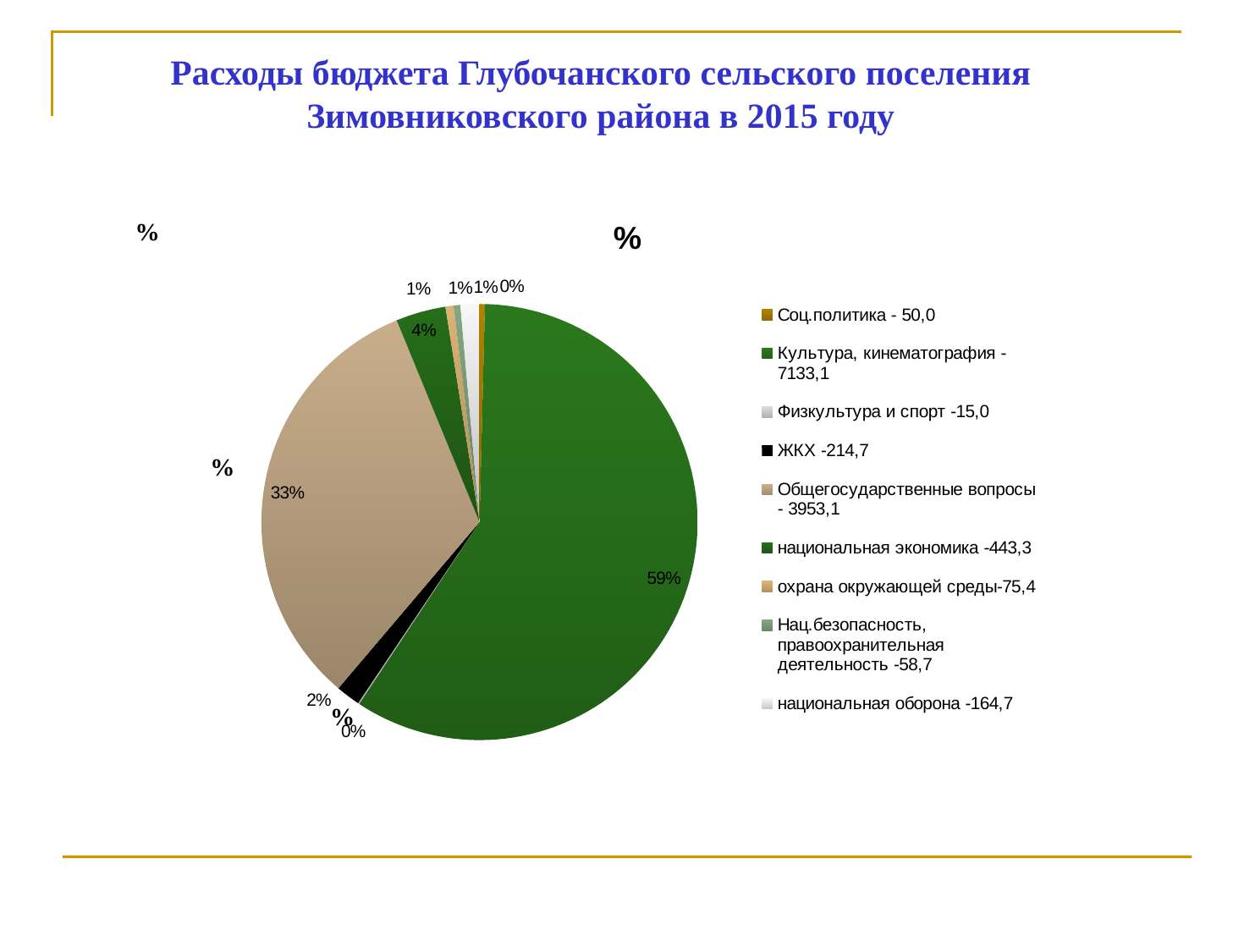
How many categories does the legend of the pie chart list? 9 Which slice is larger: Общегосударственные вопросы or национальная экономика? Общегосударственные вопросы What value is given in the legend for Соц.политика? 50,0 Which category has the smallest value according to the legend? Физкультура и спорт What value is given in the legend for национальная оборона? 164,7 What share of the pie does the slice for Культура, кинематография represent? 59% By how many percentage points does the Культура, кинематография slice exceed the Общегосударственные вопросы slice? 26% Which category has the largest slice of the pie? Культура, кинематография What share of the pie does the slice for Общегосударственные вопросы represent? 33% What percentage label is shown for the ЖКХ slice? 2% What kind of chart is shown on the slide? pie chart